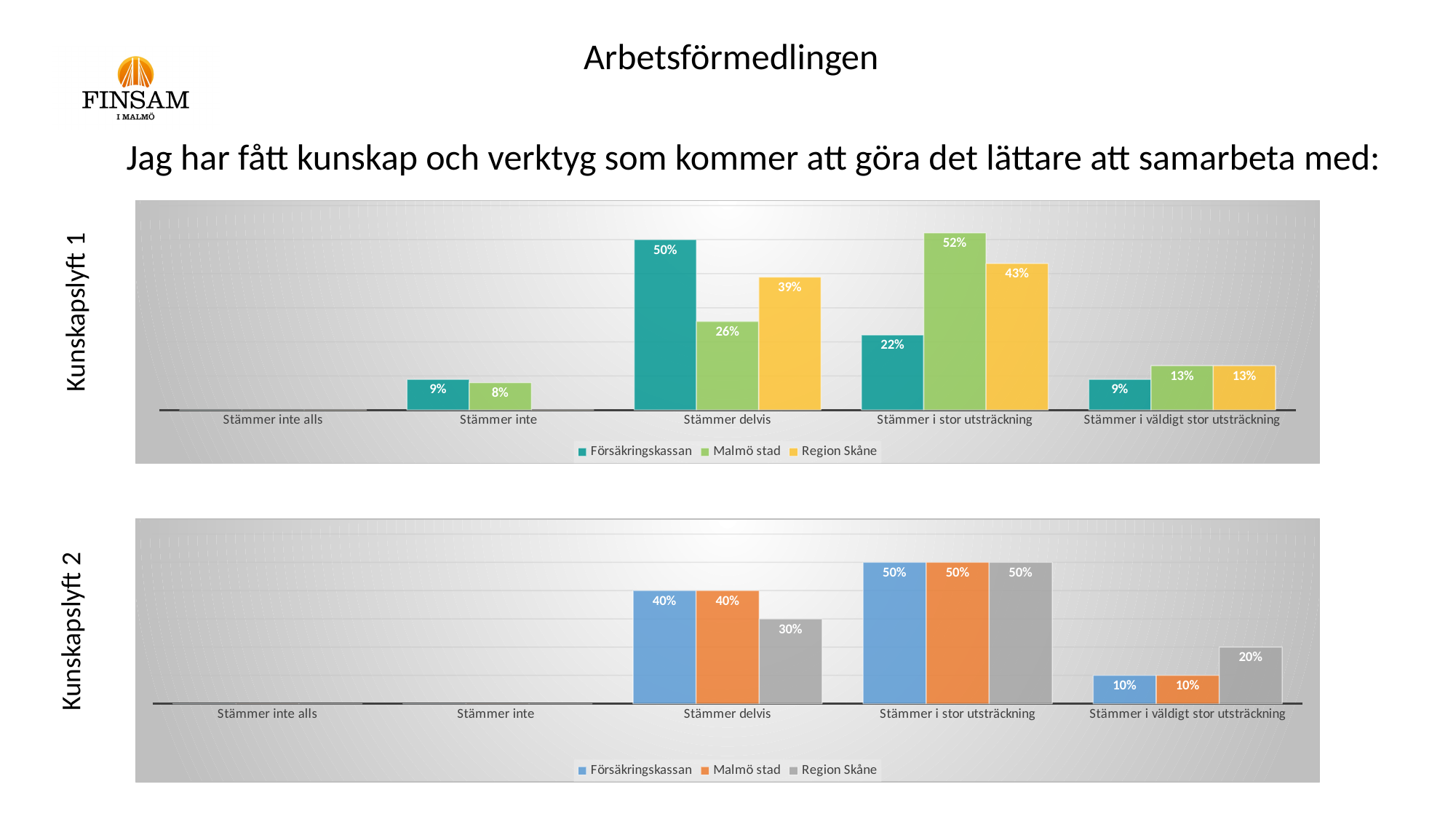
In the Kunskapslyft 1 chart, what is the difference between the Malmö stad and Försäkringskassan values in the 'Stämmer i stor utsträckning' category? 30% In the Kunskapslyft 1 chart, what is the value for Försäkringskassan in the 'Stämmer delvis' category? 50% How many categories are shown on the x axis of the Kunskapslyft 1 chart? 5 In the Kunskapslyft 1 chart, what is the value for Malmö stad in the 'Stämmer i stor utsträckning' category? 52% In the Kunskapslyft 2 chart, what is the difference between the Försäkringskassan values for 'Stämmer i stor utsträckning' and 'Stämmer delvis'? 10% In the Kunskapslyft 1 chart, which is larger in the 'Stämmer delvis' category: Malmö stad or Region Skåne? Region Skåne How many series does the legend of the Kunskapslyft 2 chart list? 3 In the Kunskapslyft 1 chart, what is the value for Region Skåne in the 'Stämmer delvis' category? 39% What kind of chart is the Kunskapslyft 2 chart? Bar chart In the Kunskapslyft 2 chart, what is the value for Region Skåne in the 'Stämmer delvis' category? 30% In the Kunskapslyft 2 chart, what is the value for Region Skåne in the 'Stämmer i väldigt stor utsträckning' category? 20% In the Kunskapslyft 1 chart, which category has the highest value for Försäkringskassan? Stämmer delvis